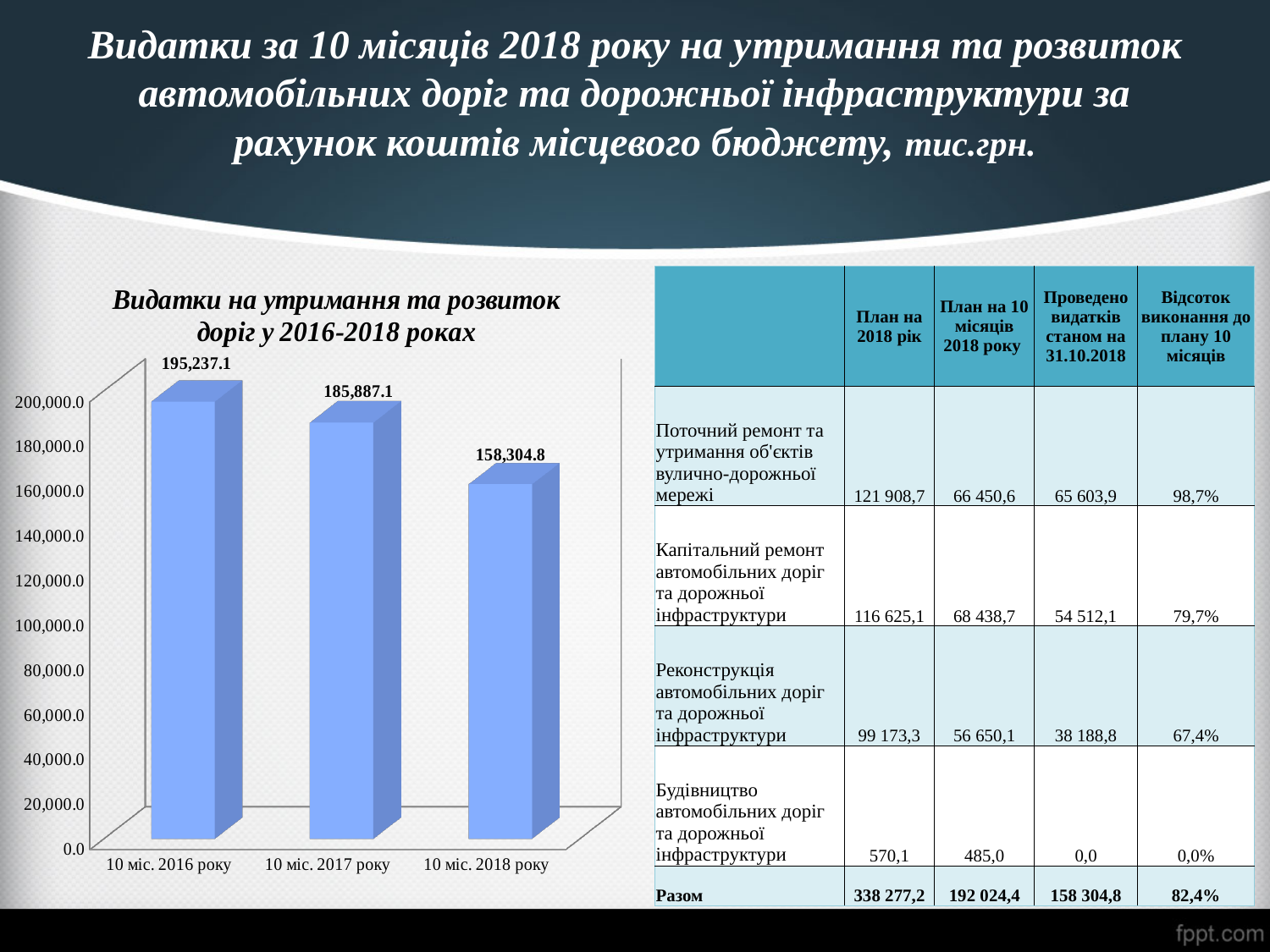
What is the difference between the values for 10 міс. 2016 року and 10 міс. 2017 року? 9,350.0 What is the value for 10 міс. 2016 року? 195,237.1 What is the value for 10 міс. 2017 року? 185,887.1 Which is larger, the value for 10 міс. 2017 року or 10 міс. 2018 року? 10 міс. 2017 року How many categories are shown on the chart? 3 What kind of chart is shown on the slide? bar chart What is the value for 10 міс. 2018 року? 158,304.8 Which category has the highest value? 10 міс. 2016 року Which category has the lowest value? 10 міс. 2018 року What is the difference between the values for 10 міс. 2016 року and 10 міс. 2018 року? 36,932.3 Do the values rise or fall from 10 міс. 2016 року to 10 міс. 2018 року? fall Is the value for 10 міс. 2018 року greater or less than 160,000.0? less